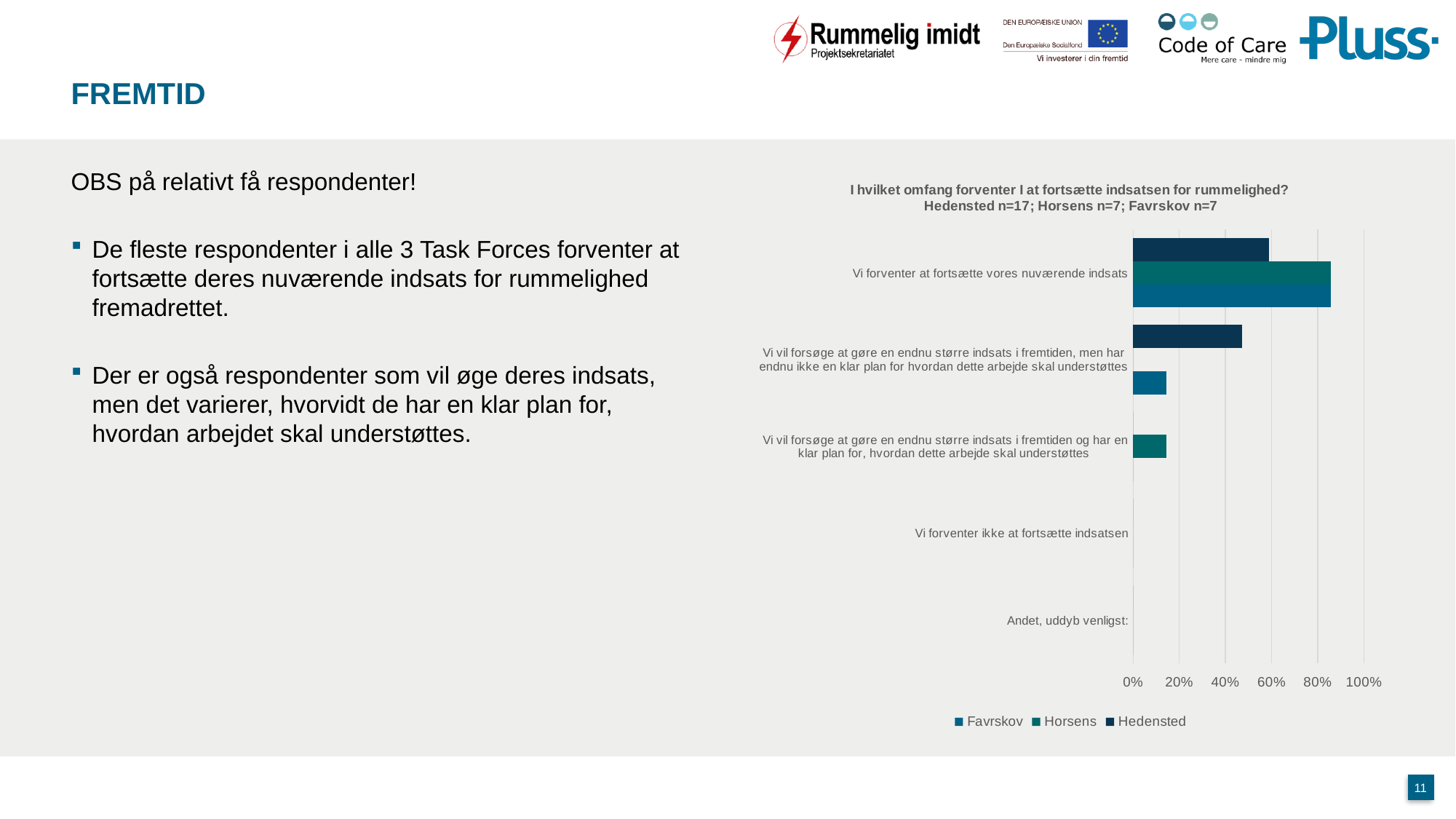
How many series does the legend list? 3 What is the highest value shown on the chart's horizontal axis? 100% How many categories are shown on the chart's vertical axis? 5 For Hedensted, which category has the highest value? Vi forventer at fortsætte vores nuværende indsats Is the Hedensted value for 'Vi forventer at fortsætte vores nuværende indsats' greater or less than 80%? less What kind of chart is shown on the slide? bar chart Which series are listed in the chart legend? Favrskov, Horsens, Hedensted Which series has a bar for 'Vi vil forsøge at gøre en endnu større indsats i fremtiden og har en klar plan for, hvordan dette arbejde skal understøttes'? Horsens For 'Vi forventer at fortsætte vores nuværende indsats', which is larger: the Horsens value or the Hedensted value? Horsens Is the Favrskov value for 'Vi vil forsøge at gøre en endnu større indsats i fremtiden, men har endnu ikke en klar plan for hvordan dette arbejde skal understøttes' greater or less than 20%? less Is the Horsens value for 'Vi forventer at fortsætte vores nuværende indsats' greater or less than 80%? greater